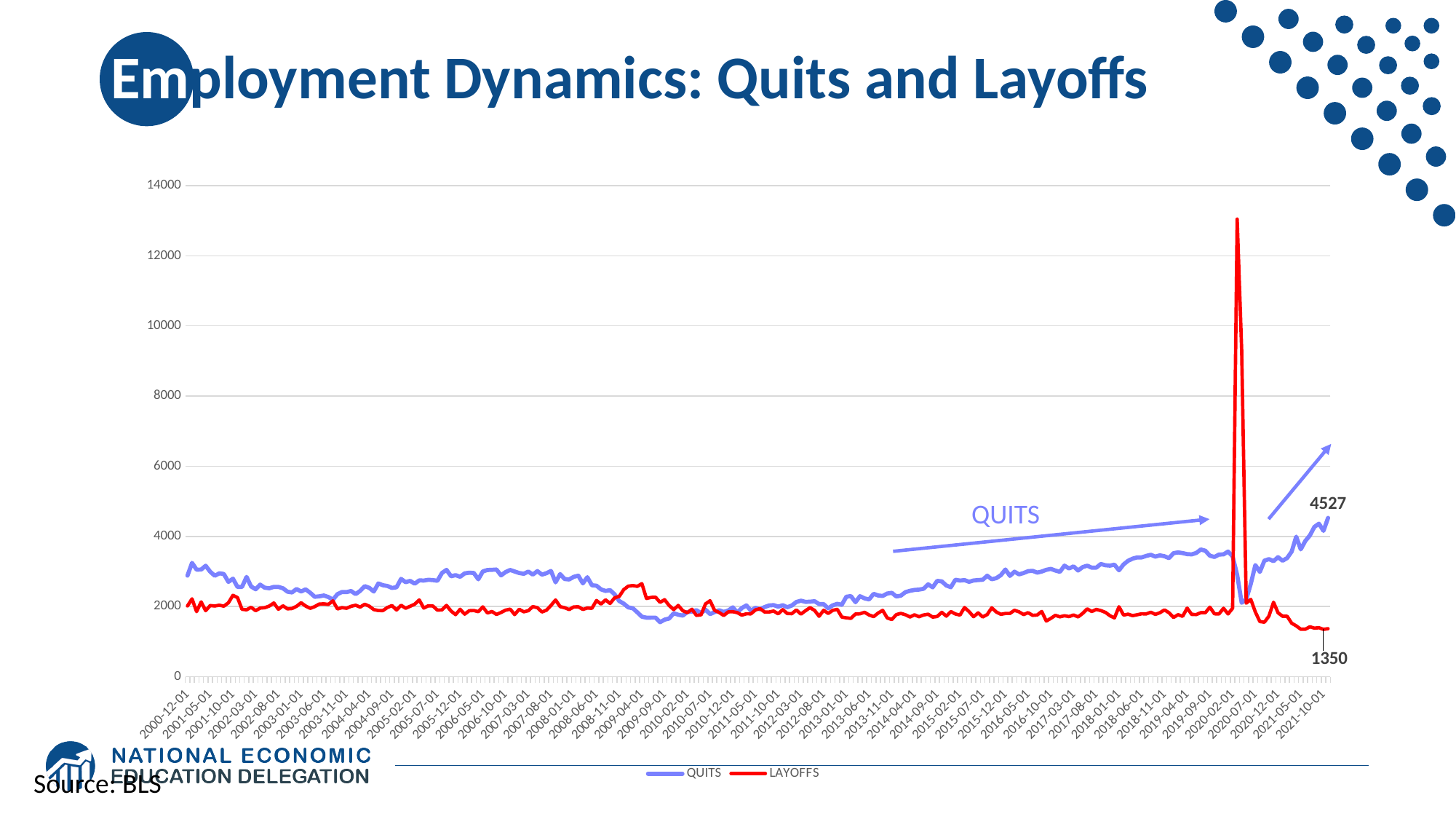
Is the value of the QUITS series at 2000-12-01 greater or less than 2000? greater What is the difference between the labelled final values of QUITS (4527) and LAYOFFS (1350)? 3177 What is the title of the slide? Employment Dynamics: Quits and Layoffs How many series does the legend list? 2 Is the peak value of the LAYOFFS series in 2020 greater or less than 12000? greater What is the labelled final value of the QUITS series? 4527 What is the labelled final value of the LAYOFFS series? 1350 Is the value of the QUITS series around 2009-09-01 greater or less than 2000? less Does the QUITS series generally rise or fall between 2013 and 2021? rise Which series reaches the highest value anywhere on the chart? LAYOFFS At the end of the chart, which series has the larger value, QUITS or LAYOFFS? QUITS What kind of chart is shown on the slide? line chart